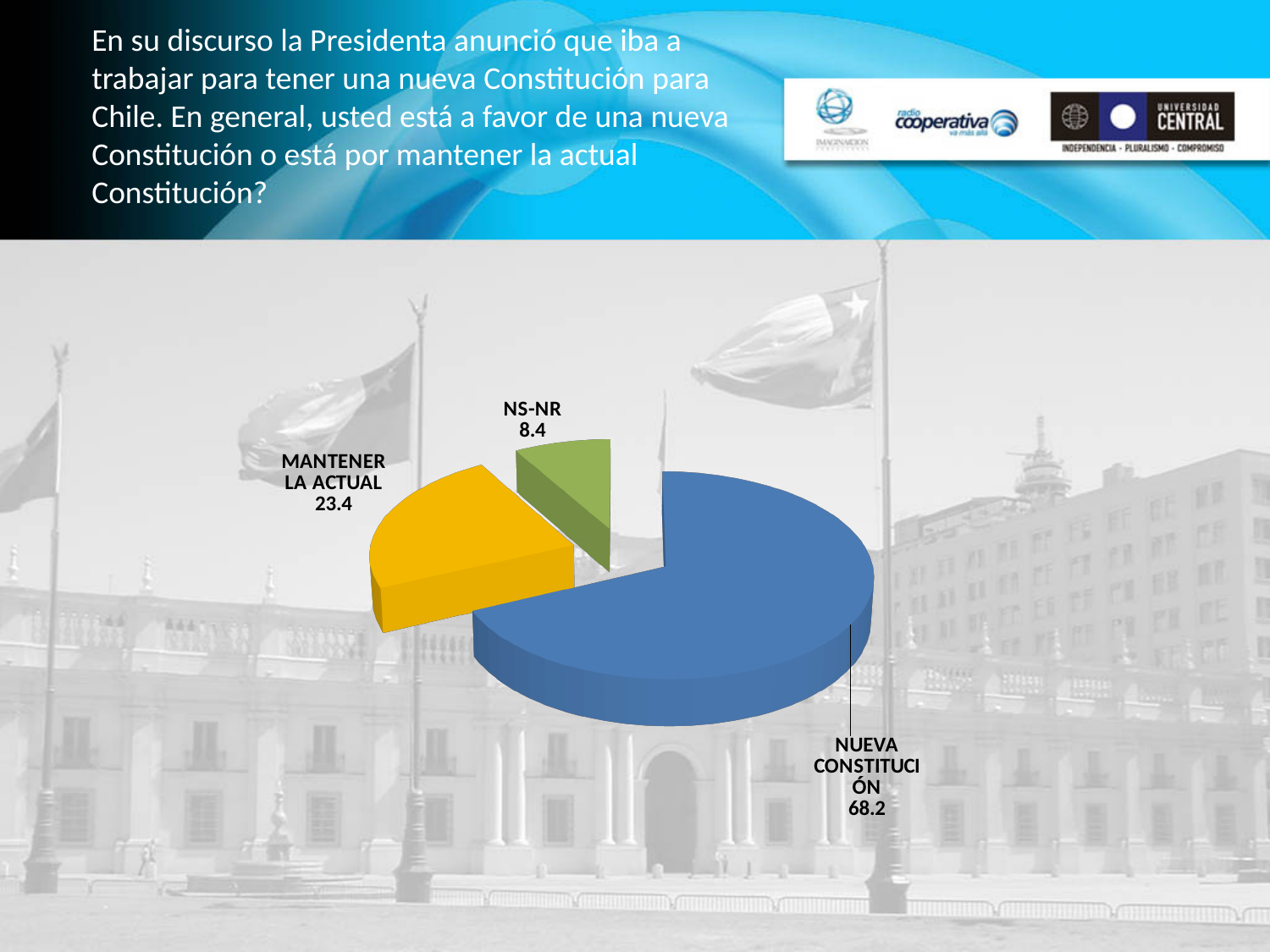
What is the difference between the values for NUEVA CONSTITUCIÓN and MANTENER LA ACTUAL? 44.8 Which category has the smallest slice? NS-NR Which is larger, MANTENER LA ACTUAL or NS-NR? MANTENER LA ACTUAL What is the value for NS-NR? 8.4 What is the value for NUEVA CONSTITUCIÓN? 68.2 What colour is the NUEVA CONSTITUCIÓN slice? blue What colour is the MANTENER LA ACTUAL slice? yellow What kind of chart is shown on the slide? pie chart What is the value for MANTENER LA ACTUAL? 23.4 What is the difference between the values for MANTENER LA ACTUAL and NS-NR? 15.0 How many slices does the pie chart have? 3 Which category has the largest slice? NUEVA CONSTITUCIÓN